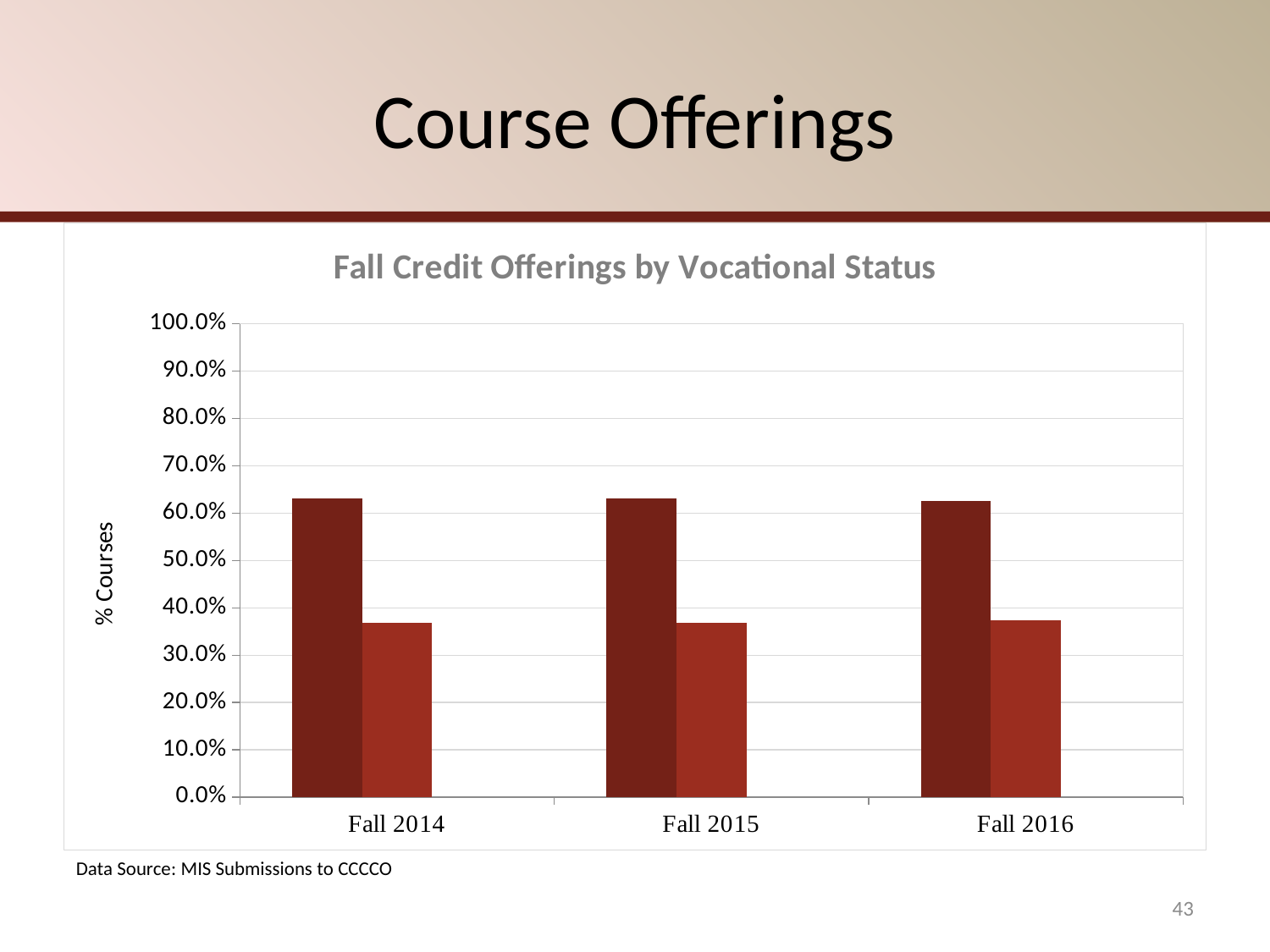
Is the value of the lighter red bar for Fall 2016 greater or less than 30.0%? greater Is the value of the dark red bar for Fall 2015 greater or less than 70.0%? less How many bars are shown for each fall term in the chart? 2 Is the value of the dark red bar for Fall 2016 greater or less than 50.0%? greater What kind of chart is shown on the slide? bar chart What is the label on the vertical axis of the chart? % Courses For Fall 2015, which bar is taller, the dark red bar or the lighter red bar? the dark red bar What is the title of the chart? Fall Credit Offerings by Vocational Status How many fall terms are shown on the x axis of the chart? 3